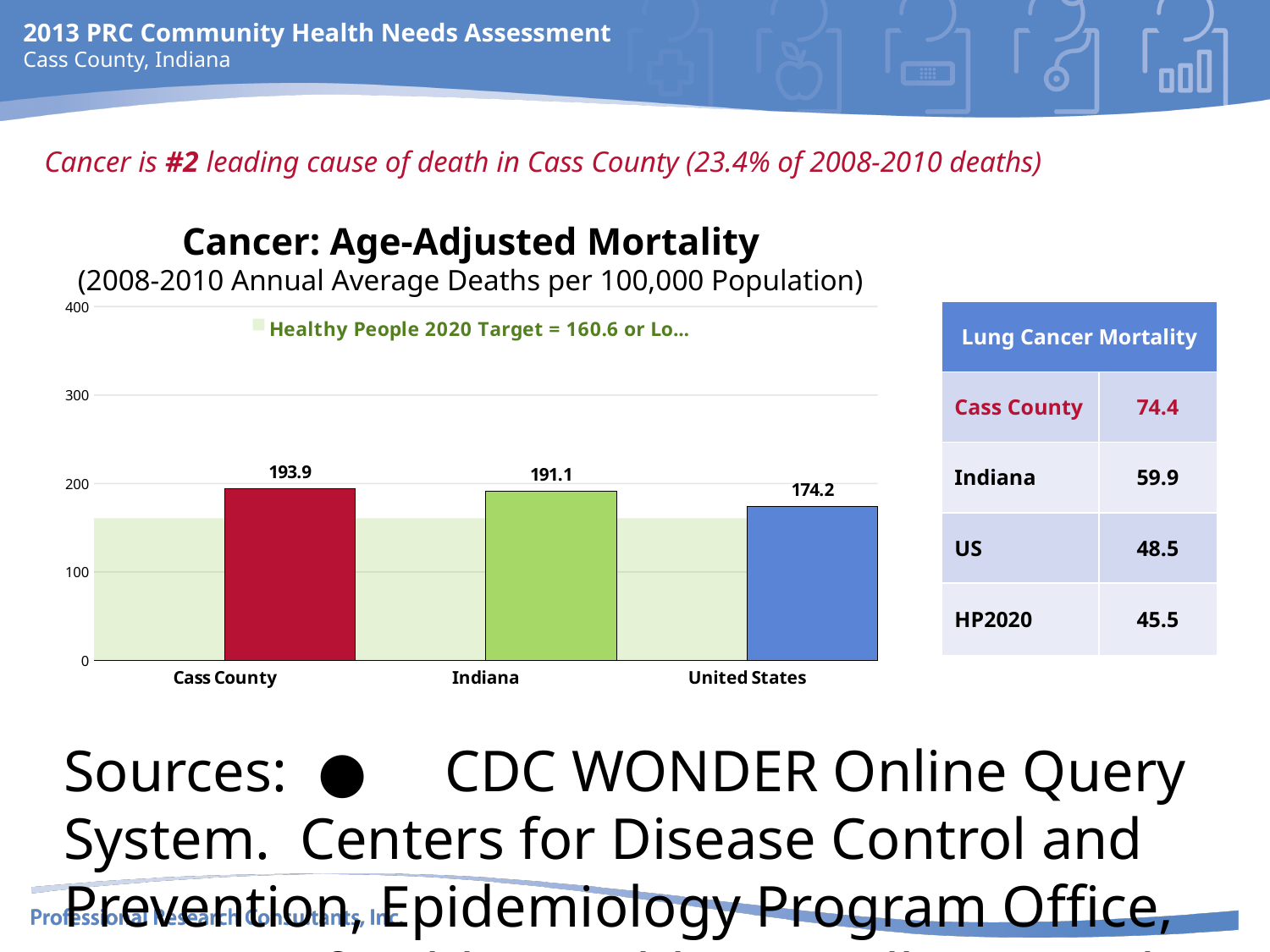
What is the difference between the Cass County and United States values in the Cancer: Age-Adjusted Mortality chart? 19.7 How many categories are shown on the x axis of the Cancer: Age-Adjusted Mortality chart? 3 Which category has the highest value in the Cancer: Age-Adjusted Mortality chart? Cass County In the Cancer: Age-Adjusted Mortality chart, is the value for United States greater or less than 200? less What kind of chart is the Cancer: Age-Adjusted Mortality chart? bar chart Do the values in the Cancer: Age-Adjusted Mortality chart rise or fall from left to right along the x axis? fall What is the value for United States in the Cancer: Age-Adjusted Mortality chart? 174.2 Which category has the lowest value in the Cancer: Age-Adjusted Mortality chart? United States What is the difference between the Indiana and United States values in the Cancer: Age-Adjusted Mortality chart? 16.9 In the Cancer: Age-Adjusted Mortality chart, which is larger, the value for Indiana or the value for United States? Indiana What is the value for Cass County in the Cancer: Age-Adjusted Mortality chart? 193.9 What is the value for Indiana in the Cancer: Age-Adjusted Mortality chart? 191.1